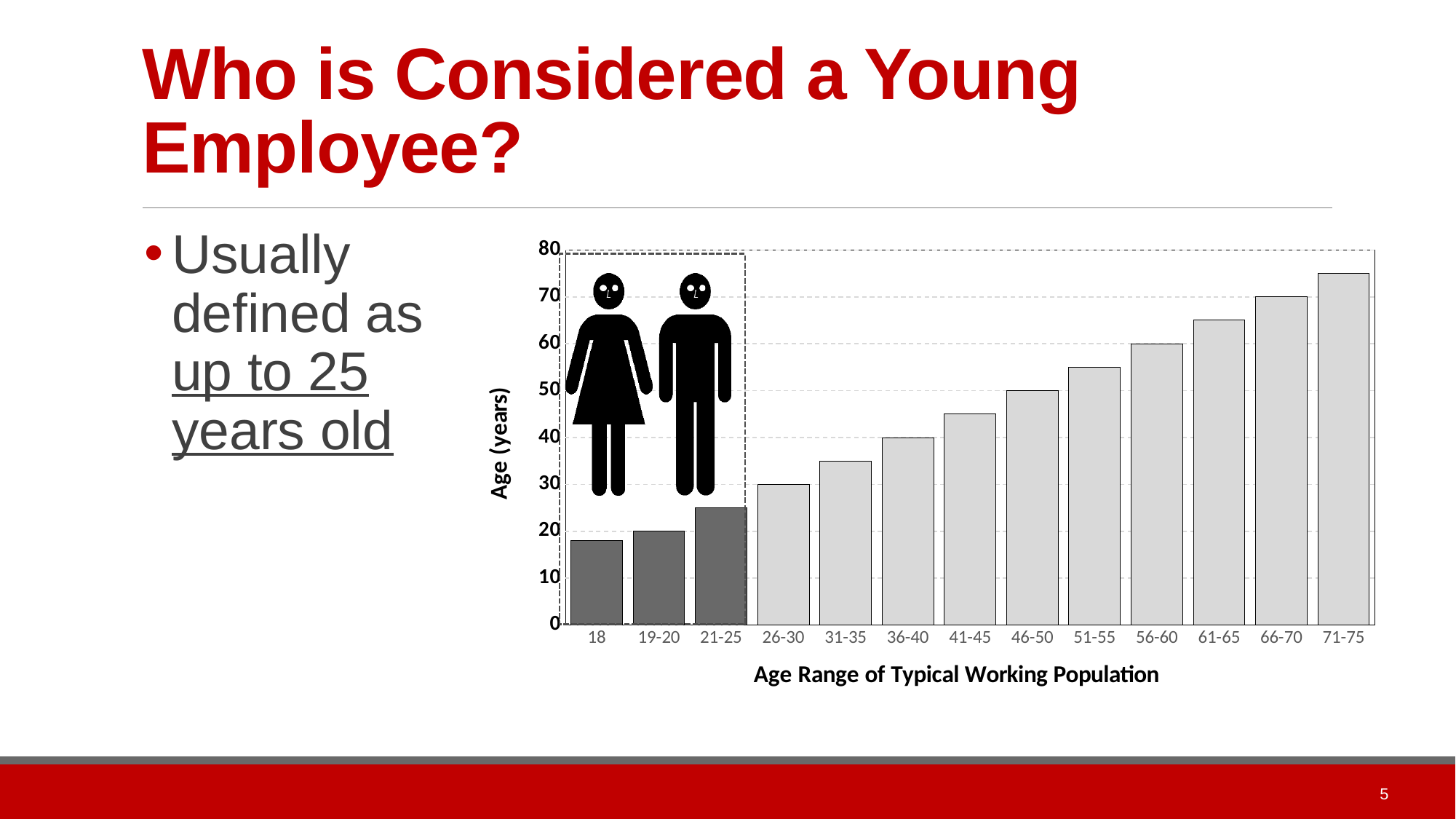
What is the value for the 26-30 category? 30 What is the difference between the values for 66-70 and 26-30? 40 What is the value for the 66-70 category? 70 Which category has the highest bar? 71-75 What is the value for the 19-20 category? 20 Do the bar values rise or fall from left to right along the x axis? Rise How many age-range categories are shown on the x axis of the chart? 13 What kind of chart is shown on the slide? Bar chart Which category has the lowest bar? 18 What is the title of the y axis of the chart? Age (years) Is the value for 71-75 greater or less than 70? greater Is the value for 21-25 greater or less than 30? less